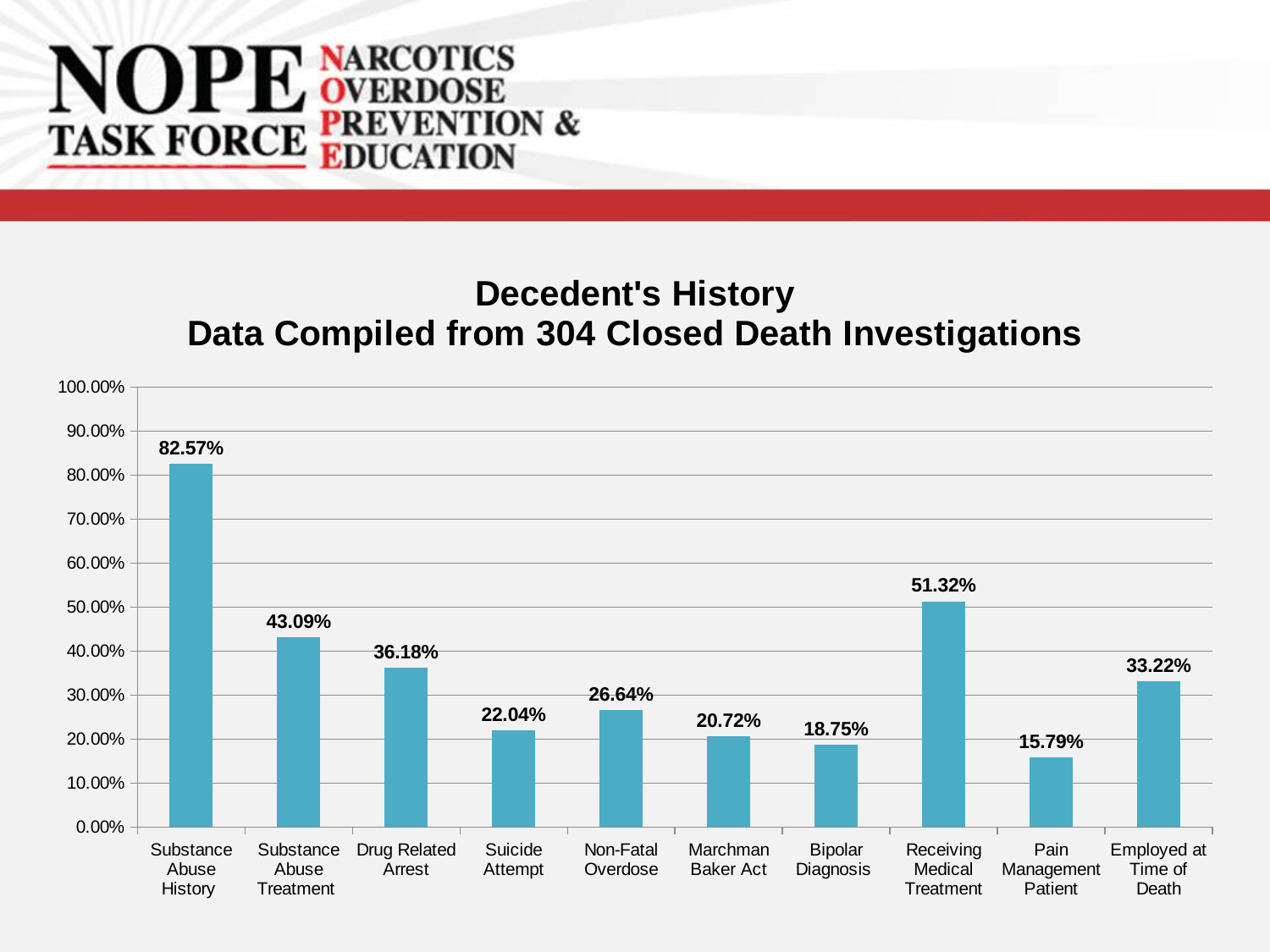
What is the difference between Substance Abuse History and Substance Abuse Treatment? 39.48% What is the title of the chart? Decedent's History Data Compiled from 304 Closed Death Investigations What kind of chart is shown on the slide? bar chart What is the value for Pain Management Patient? 15.79% Is the value for Non-Fatal Overdose greater or less than 30.00%? less Which category has the lowest value? Pain Management Patient How many categories are shown on the x axis? 10 Which category has the highest value? Substance Abuse History Which is larger, Drug Related Arrest or Employed at Time of Death? Drug Related Arrest What is the value for Receiving Medical Treatment? 51.32% What is the difference between Marchman Baker Act and Bipolar Diagnosis? 1.97% What is the value for Substance Abuse History? 82.57%